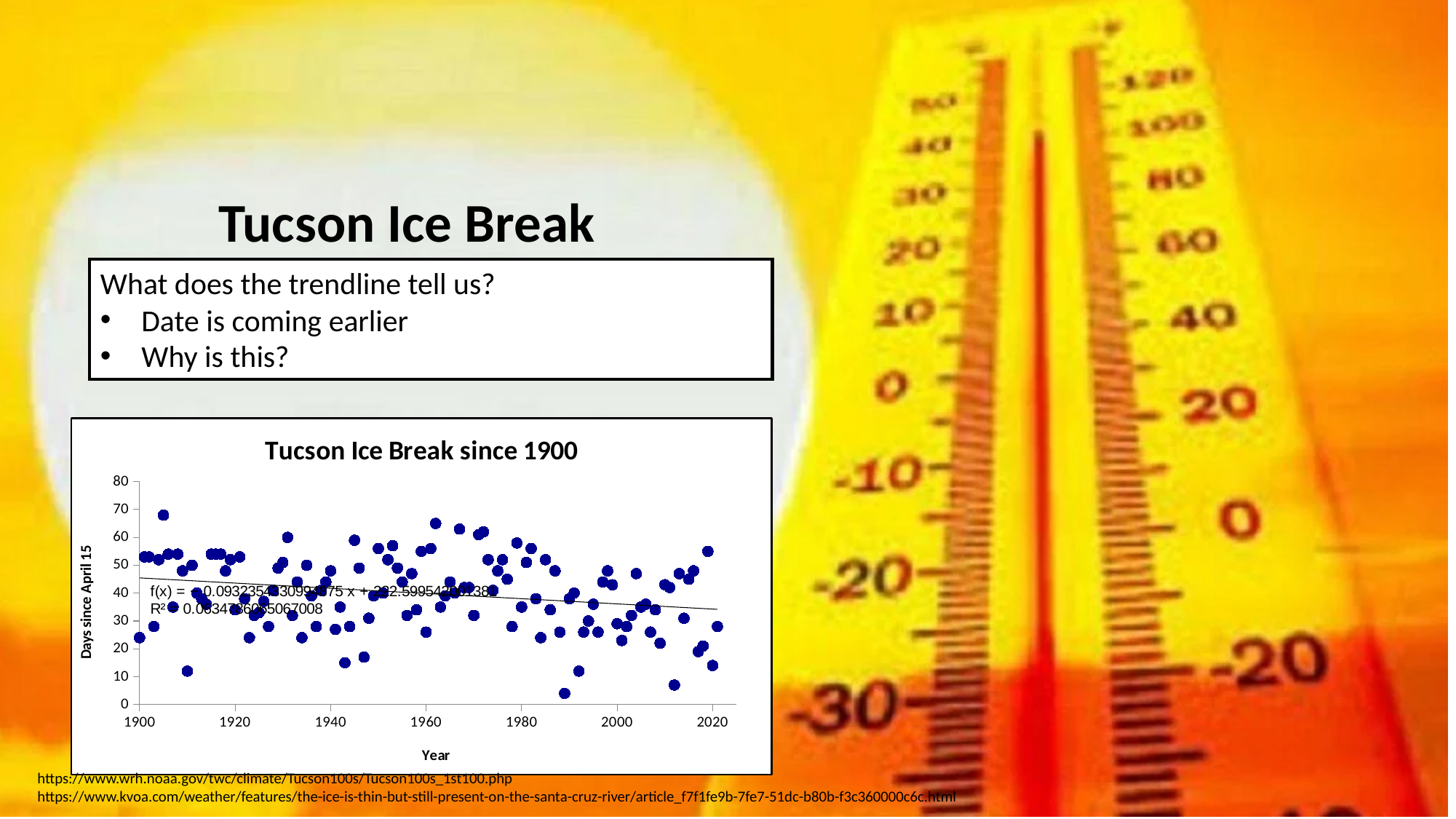
What is the title of the chart? Tucson Ice Break since 1900 What kind of chart is shown on the slide? scatter chart Is the trendline value at the year 1900 greater or less than 40 days since April 15? greater Is the trendline value at the year 2020 greater or less than 40 days since April 15? less What is the label of the vertical axis of the chart? Days since April 15 Is the highest plotted point in the chart greater or less than 60 days since April 15? greater Which is larger: the trendline value at 1900 or the trendline value at 2020? 1900 Does the trendline in the chart rise or fall as the year increases? fall